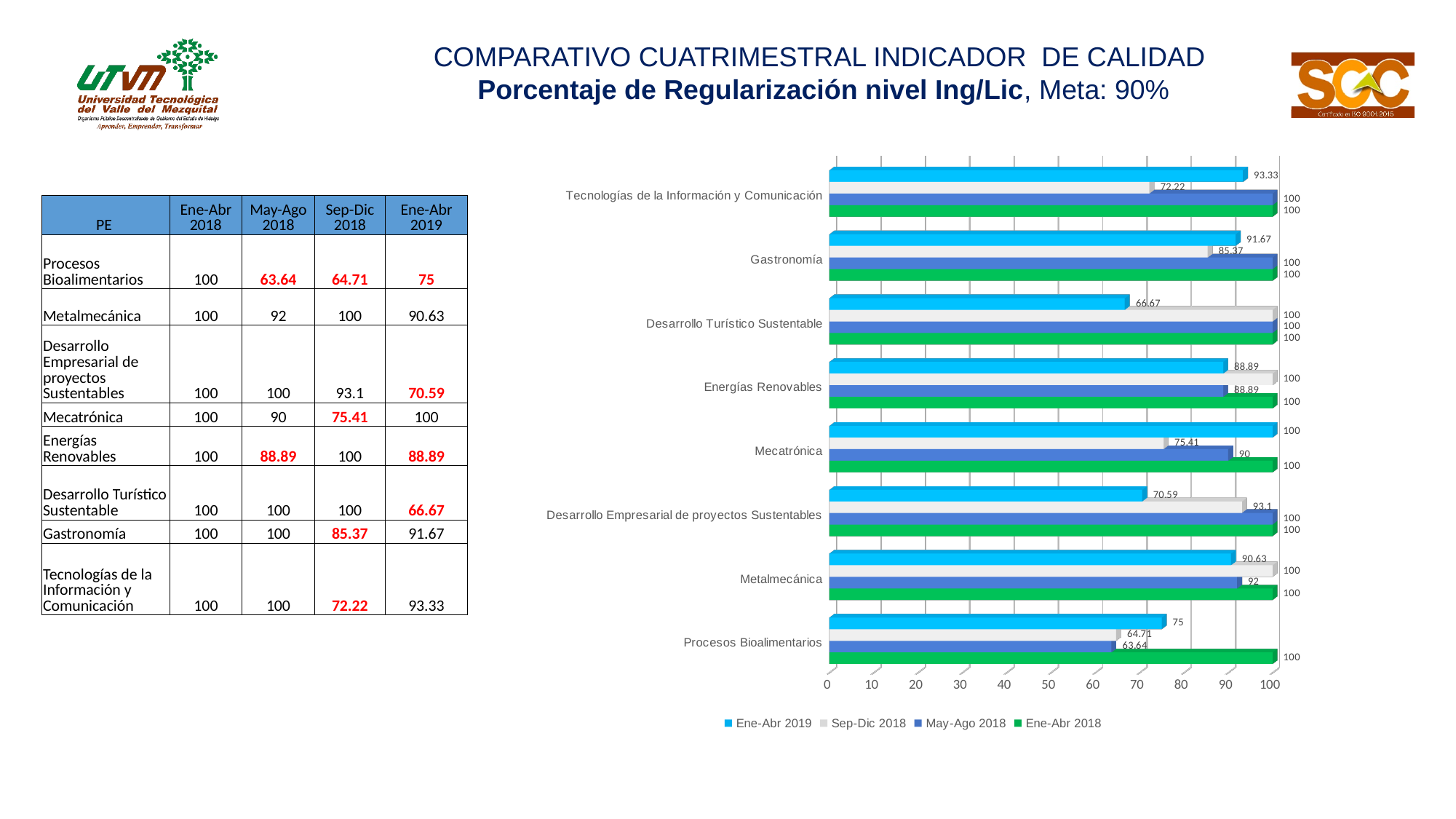
What is the May-Ago 2018 value for Procesos Bioalimentarios? 63.64 Is the Sep-Dic 2018 value for Mecatrónica greater or less than 80? less For Metalmecánica, which is larger: the Ene-Abr 2019 value or the May-Ago 2018 value? May-Ago 2018 Which program has the lowest Ene-Abr 2019 value? Desarrollo Turístico Sustentable What is the Sep-Dic 2018 value for Desarrollo Empresarial de proyectos Sustentables? 93.1 What is the Ene-Abr 2019 value for Tecnologías de la Información y Comunicación? 93.33 What is the difference between the Ene-Abr 2019 value and the Sep-Dic 2018 value for Procesos Bioalimentarios? 10.29 What kind of chart is shown on the slide? bar chart How many programs (categories) are plotted on the chart? 8 What is the Sep-Dic 2018 value for Gastronomía? 85.37 How many series does the chart legend list? 4 Which colour represents the Ene-Abr 2018 series in the chart? green